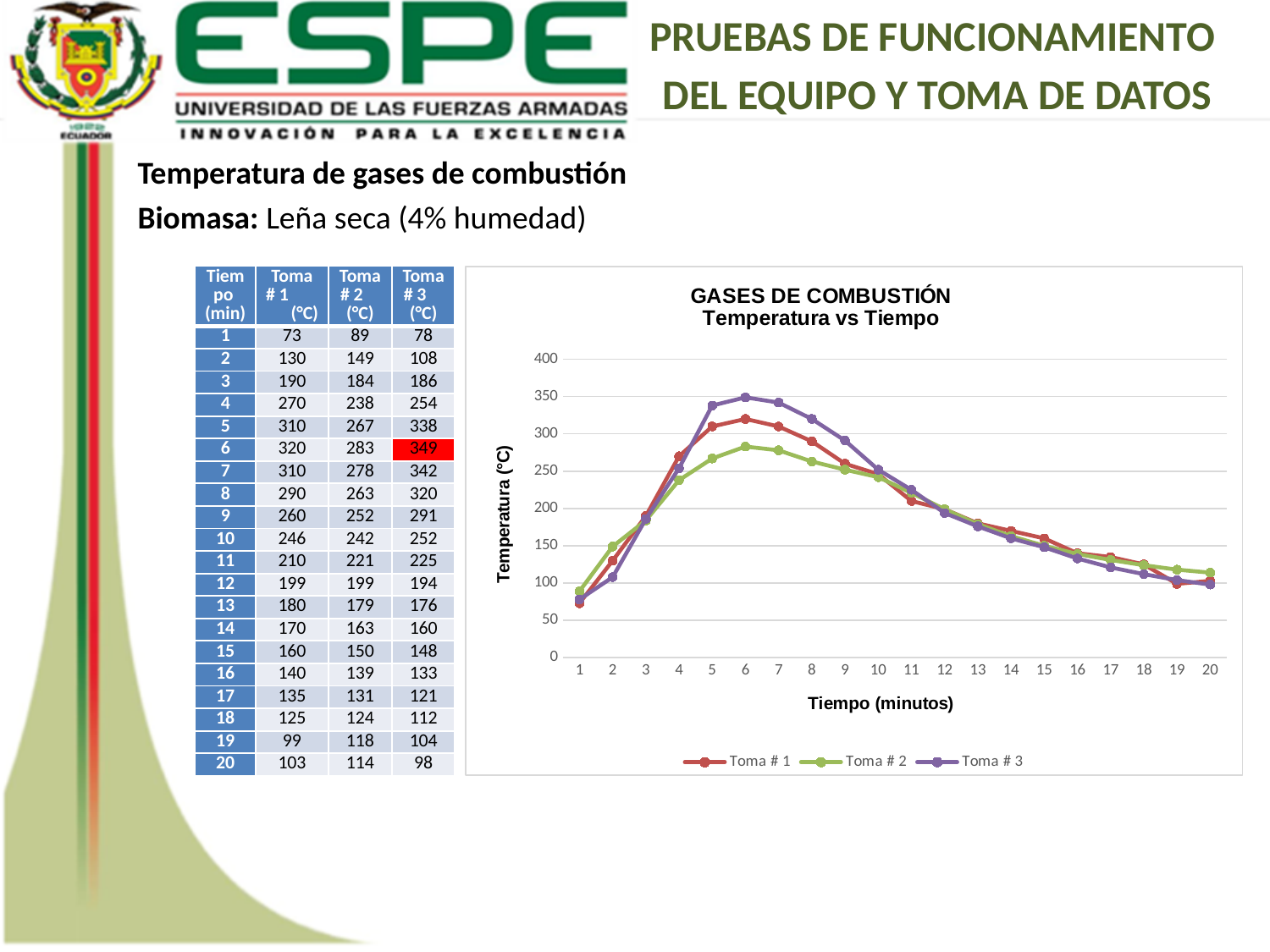
How many time points are plotted along the x axis of the chart? 20 Is the value for Toma # 3 at minute 6 greater or less than 300? greater What is the difference between Toma # 3 and Toma # 1 at minute 6? 29 What is the peak temperature of Toma # 3, reached at minute 6? 349 At minute 6, which is larger: Toma # 2 or Toma # 3? Toma # 3 How many series does the chart legend list? 3 From minute 6 to minute 20, does the Toma # 1 line rise or fall? falls Which series reaches the highest temperature in the chart? Toma # 3 Is the value for Toma # 2 at minute 1 greater or less than 100? less What is the temperature of Toma # 1 at minute 1? 73 What is the title of the y axis of the chart? Temperatura (°C) What kind of chart is shown on the slide? line chart